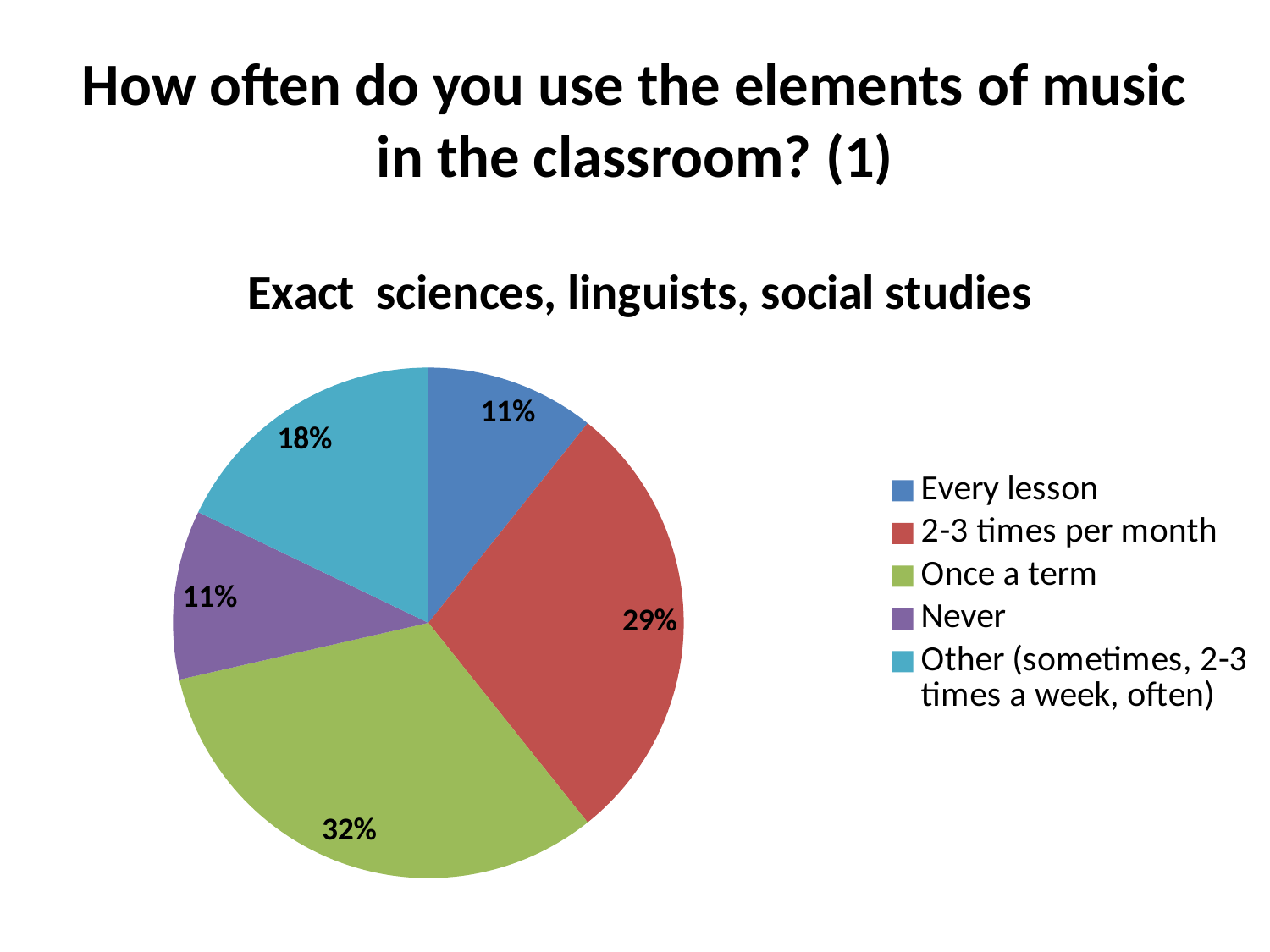
What percentage of the pie is 'Never'? 11% What type of chart is shown on the slide? pie chart What percentage of the pie is 'Every lesson'? 11% Which category has the largest share of the pie? Once a term What is the chart's title? Exact sciences, linguists, social studies What percentage of the pie is '2-3 times per month'? 29% What percentage of the pie is 'Once a term'? 32% What percentage of the pie is 'Other (sometimes, 2-3 times a week, often)'? 18% Which is larger, the share for '2-3 times per month' or the share for 'Other (sometimes, 2-3 times a week, often)'? 2-3 times per month What colour is the 'Once a term' slice? green How many categories does the legend list? 5 What is the difference in percentage points between 'Once a term' and 'Never'? 21